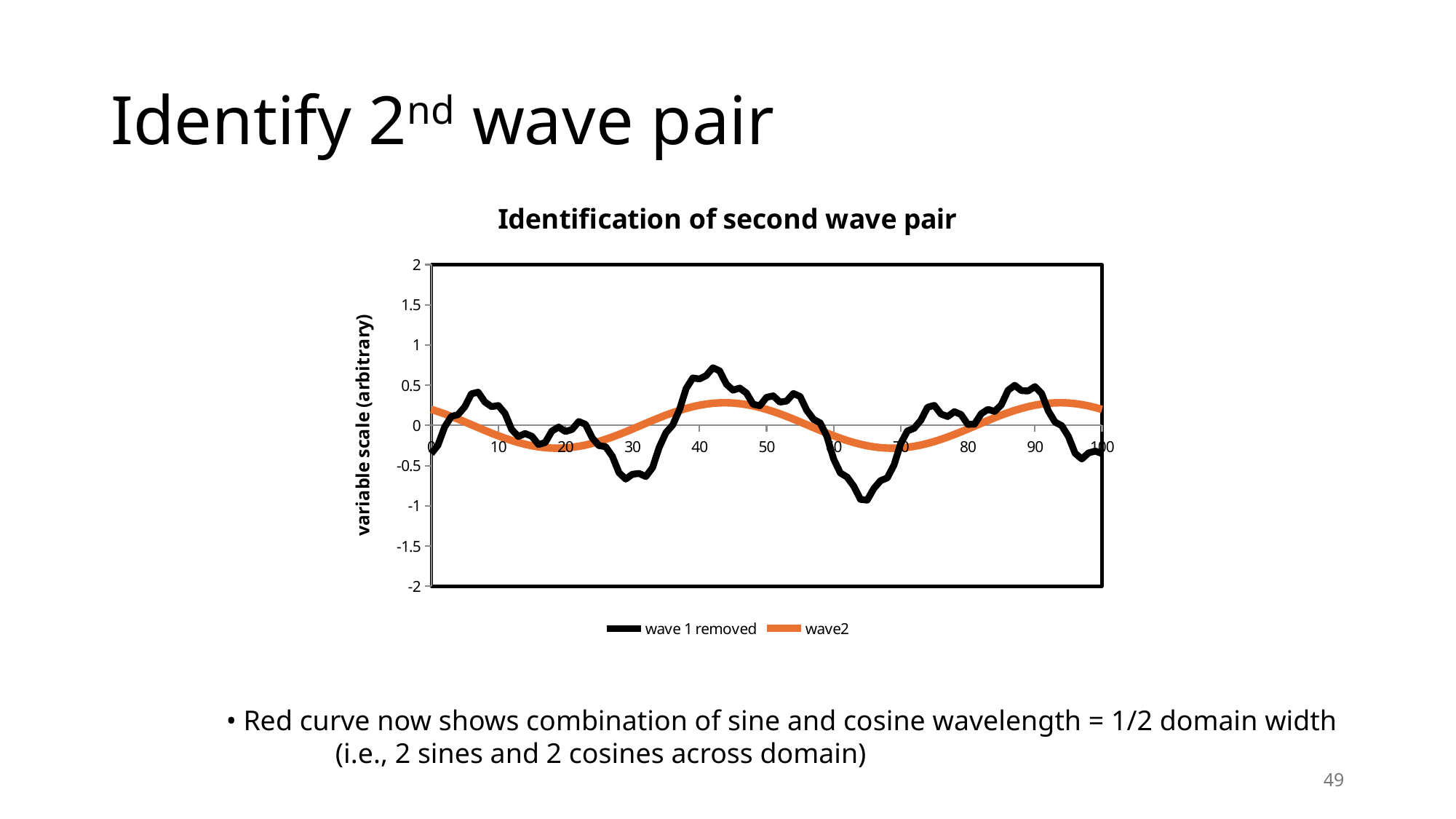
What kind of chart is shown on the slide? line chart What is the title of the chart? Identification of second wave pair Does the 'wave2' series rise or fall between x = 20 and x = 45? rise Is the value of the 'wave2' series at x = 45 greater or less than 0.5? less Is the value of the 'wave 1 removed' series at x = 42 greater or less than 0.5? greater Is the value of the 'wave 1 removed' series at x = 30 greater or less than 0? less At x = 42, which series has the higher value, 'wave 1 removed' or 'wave2'? wave 1 removed How many series does the legend list? 2 Does the 'wave 1 removed' series rise or fall between x = 42 and x = 65? fall At x = 65, which series has the higher value, 'wave 1 removed' or 'wave2'? wave2 Which series is drawn in orange? wave2